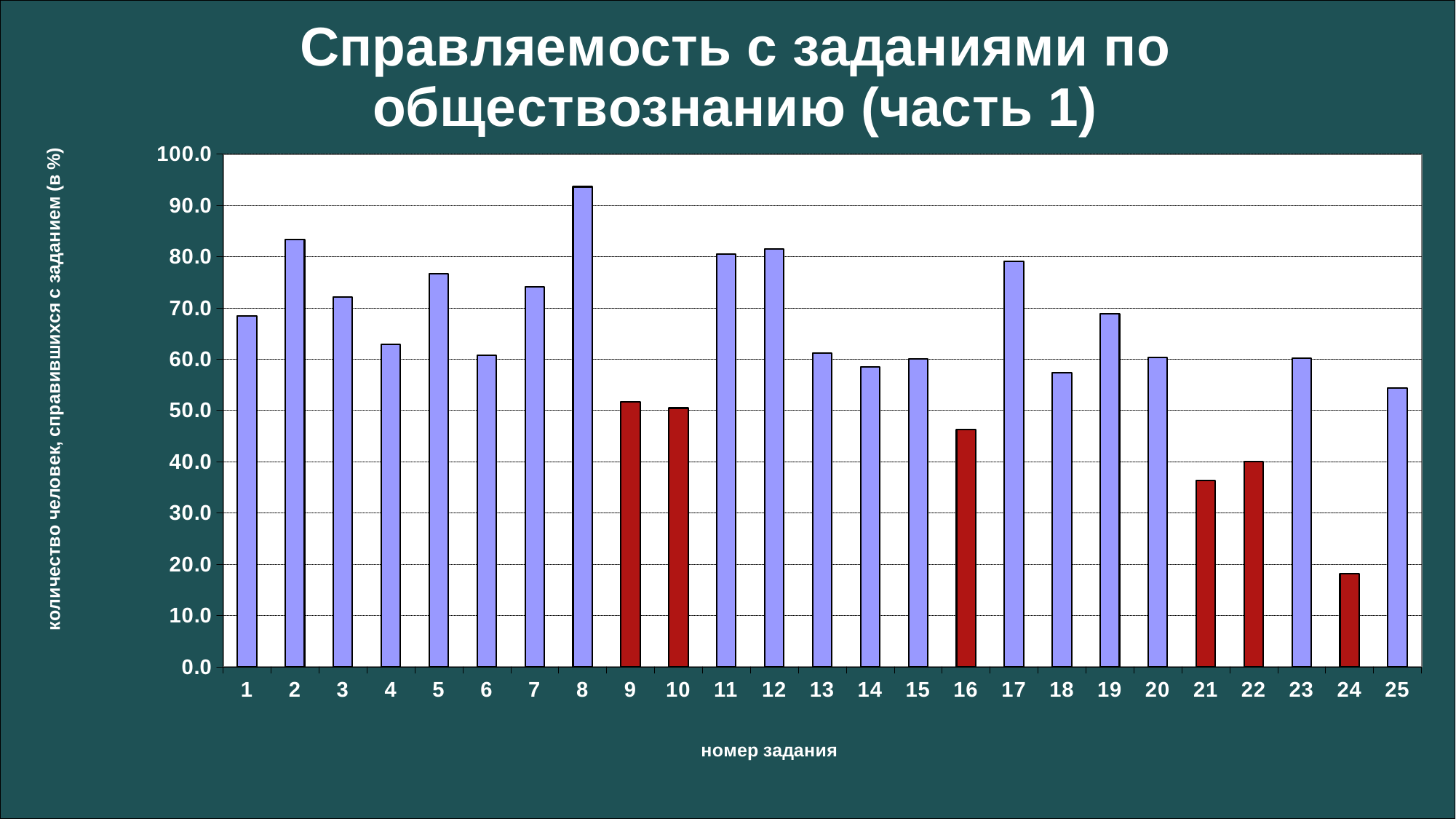
Is the value for task 8 greater or less than 90? greater Which task number has the highest value? 8 Which has the larger value, task 21 or task 22? task 22 Is the value for task 24 greater or less than 20? less What kind of chart is shown on the slide? bar chart Which has the larger value, task 2 or task 3? task 2 Which task number has the lowest value? 24 Is the value for task 2 greater or less than 80? greater What is the label of the x axis? номер задания How many bars are coloured red? 6 How many tasks (categories) are plotted on the x axis? 25